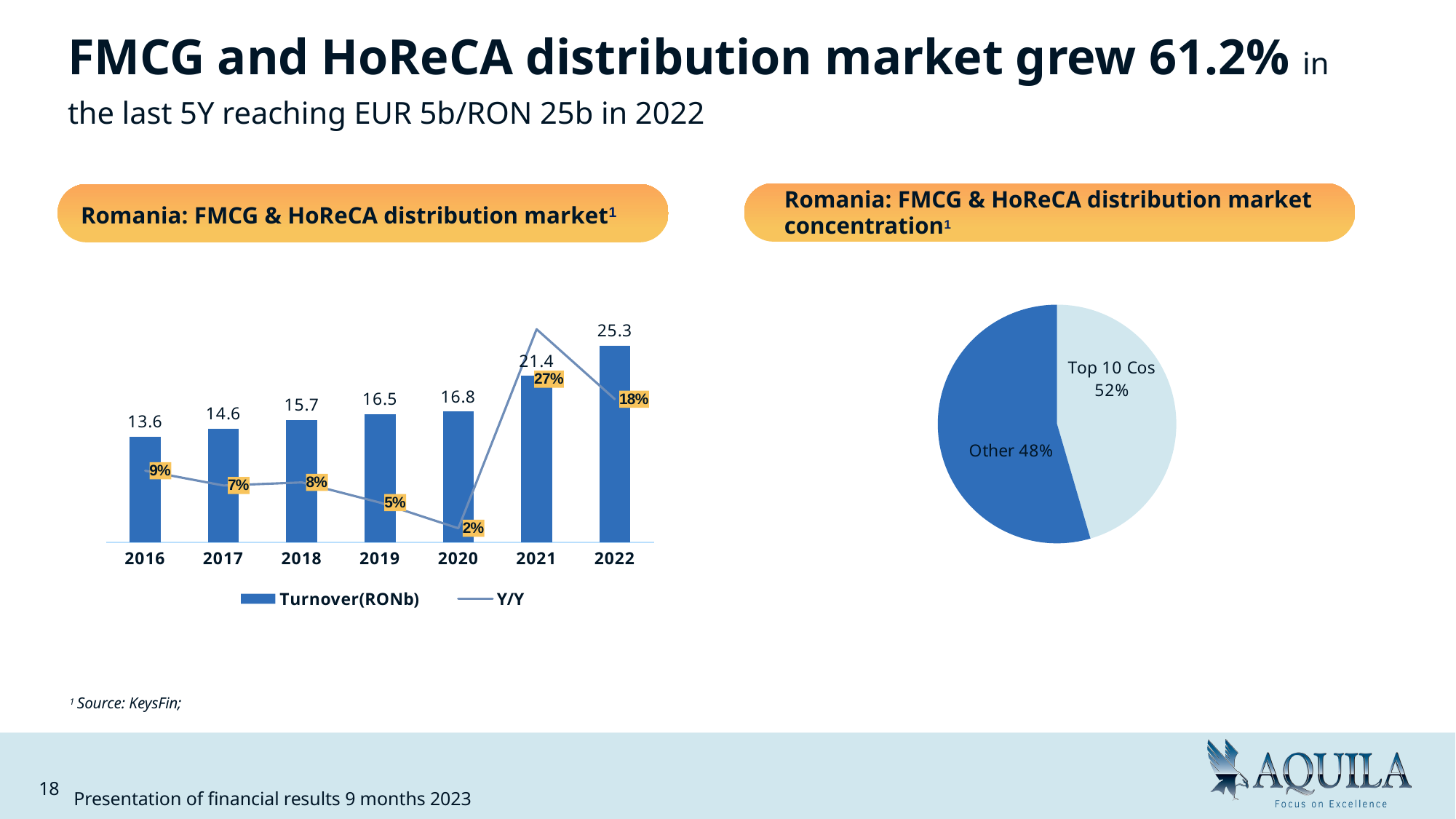
In the 'Romania: FMCG & HoReCA distribution market' chart, is the Y/Y value larger in 2016 or in 2017? 2016 In the 'Romania: FMCG & HoReCA distribution market concentration' pie chart, what share do the Top 10 Cos hold? 52% In the 'Romania: FMCG & HoReCA distribution market' chart, which year has the lowest Y/Y value? 2020 In the 'Romania: FMCG & HoReCA distribution market' chart, does Turnover(RONb) rise or fall from 2016 to 2022? rise In the 'Romania: FMCG & HoReCA distribution market' chart, what is the Turnover(RONb) value for 2019? 16.5 In the 'Romania: FMCG & HoReCA distribution market' chart, how many series does the legend list? 2 In the 'Romania: FMCG & HoReCA distribution market' chart, how many years are shown on the x axis? 7 In the 'Romania: FMCG & HoReCA distribution market' chart, what is the difference in Turnover(RONb) between 2022 and 2021? 3.9 In the 'Romania: FMCG & HoReCA distribution market' chart, what is the Y/Y value for 2021? 27% In the 'Romania: FMCG & HoReCA distribution market' chart, which year has the highest Turnover(RONb)? 2022 What kind of chart is the 'Romania: FMCG & HoReCA distribution market concentration' chart? pie chart In the 'Romania: FMCG & HoReCA distribution market' chart, what is the name of the series drawn as a line? Y/Y